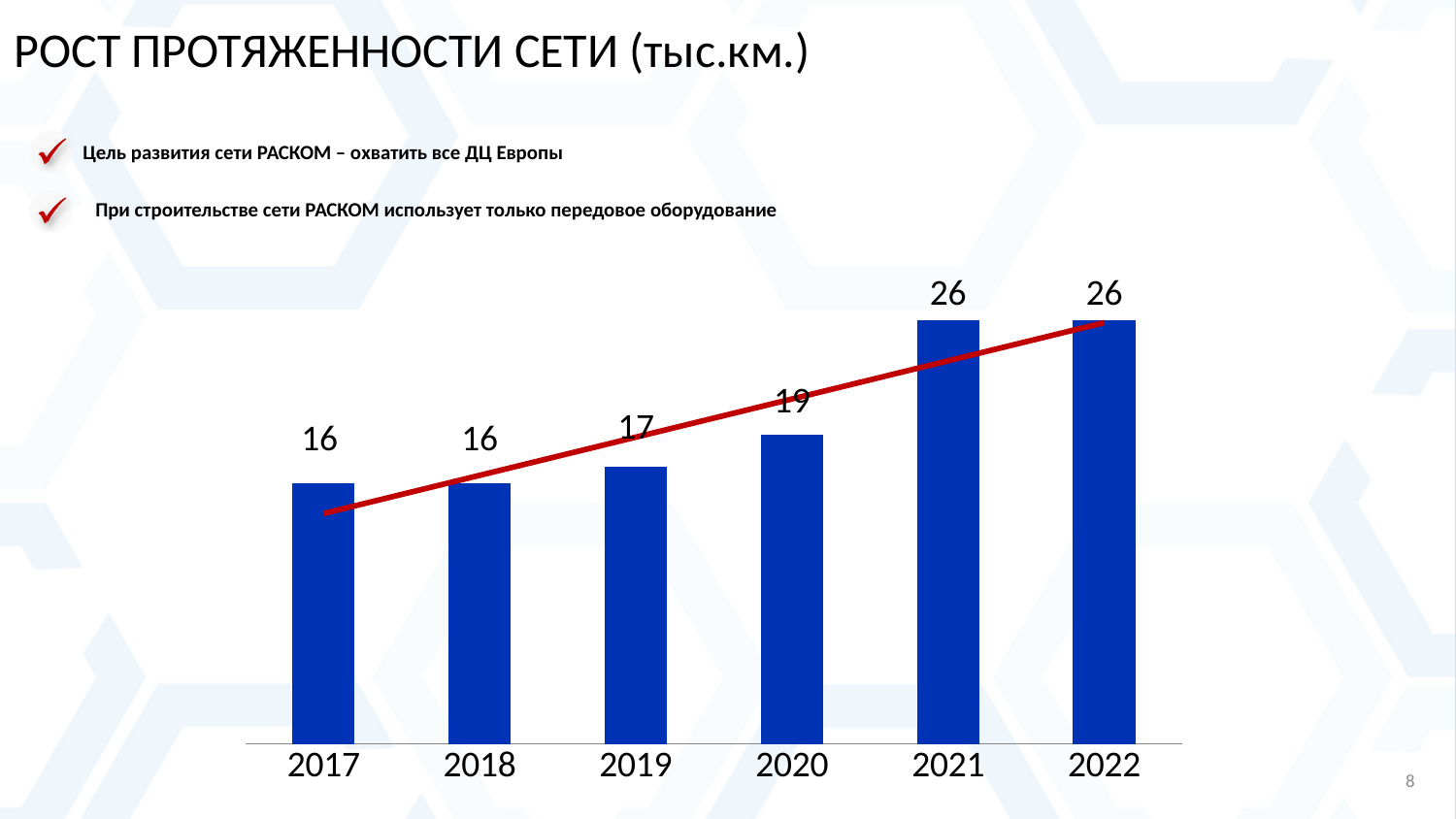
What is the value for 2020? 19 How many years are shown on the x axis? 6 What is the value for 2021? 26 What is the value for 2019? 17 What is the difference between the values for 2021 and 2020? 7 What is the value for 2017? 16 Which year has the lowest value? 2017 and 2018 What kind of chart is shown on the slide? bar chart What is the title of the slide containing the chart? РОСТ ПРОТЯЖЕННОСТИ СЕТИ (тыс.км.) What is the difference between the values for 2022 and 2017? 10 Do the values rise or fall from 2017 to 2022? rise Which is larger, the value for 2019 or the value for 2020? 2020